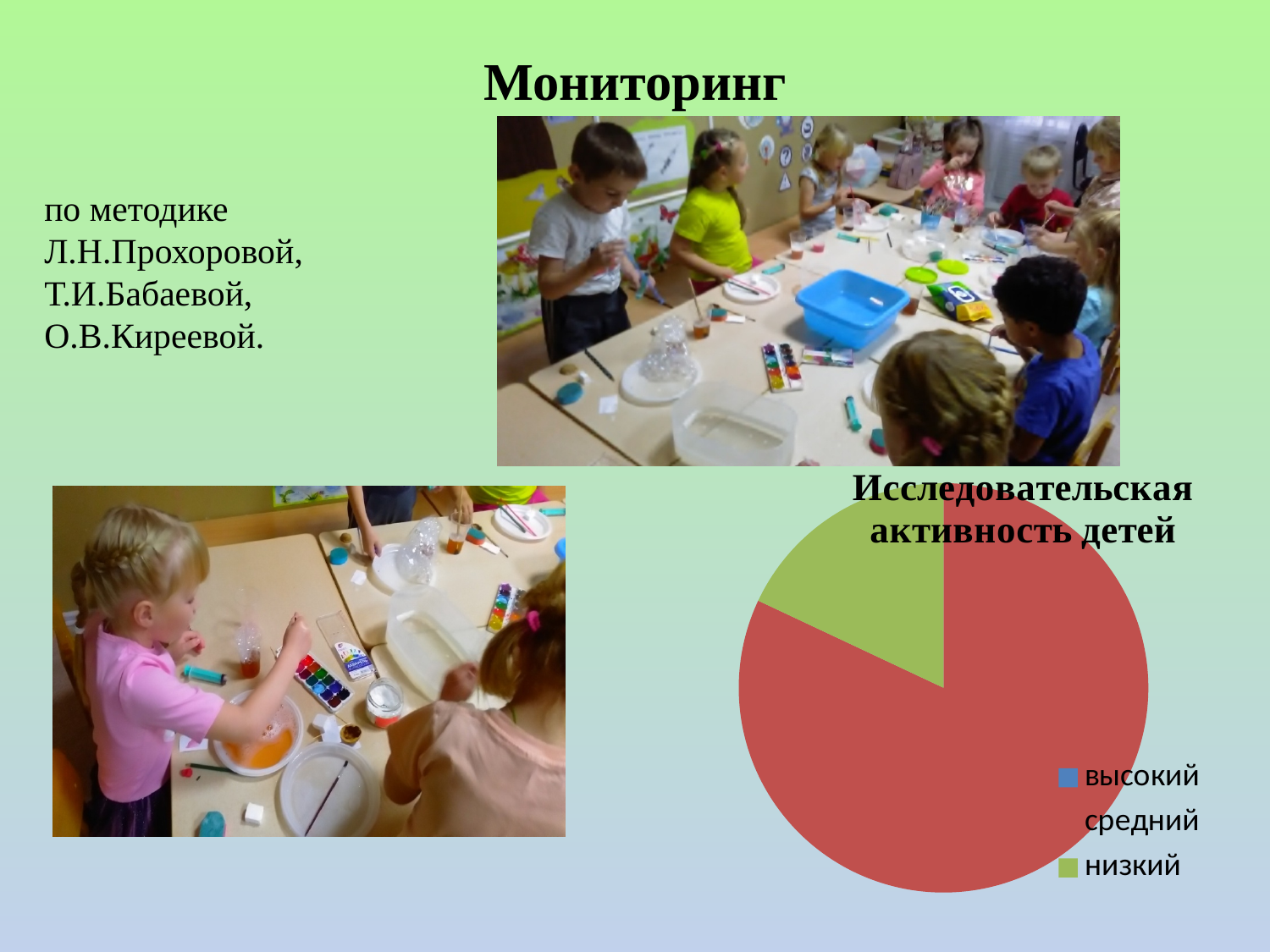
How many slices are visible in the pie chart? 2 What kind of chart is shown on the slide? pie chart Which colour slice is the largest in the pie chart? red How many entries does the legend of the pie chart list? 3 Which legend entry is marked with a green square? низкий Is the red slice of the pie chart more or less than half of the pie? more What is the title of the pie chart? Исследовательская активность детей Is the green slice of the pie chart more or less than half of the pie? less Which colour slice is the smallest of the visible slices in the pie chart? green Which is larger in the pie chart, the red slice or the green slice? the red slice